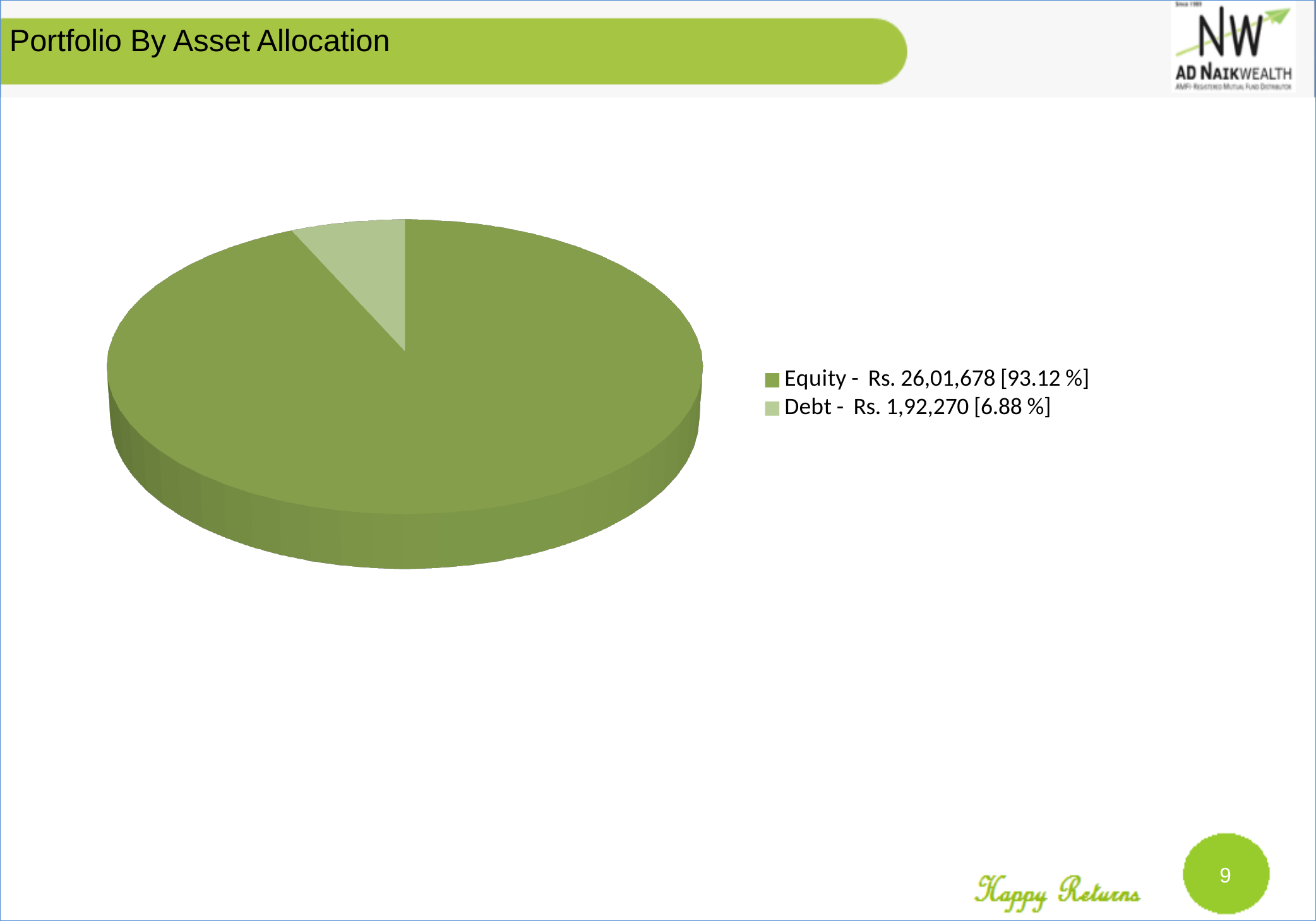
What is the difference in percentage share between Equity and Debt? 86.24 % What share of the pie does Debt represent? 6.88 % What share of the pie does Equity represent? 93.12 % What is the value for Equity in the pie chart? Rs. 26,01,678 Which category is shown in the lighter green colour in the pie chart? Debt How many categories are shown in the pie chart? 2 What is the title of the slide containing the pie chart? Portfolio By Asset Allocation What kind of chart is shown on the slide? Pie chart What is the value for Debt in the pie chart? Rs. 1,92,270 Which category has the largest slice in the pie chart? Equity Which is larger, Equity or Debt? Equity Which category has the smallest slice in the pie chart? Debt